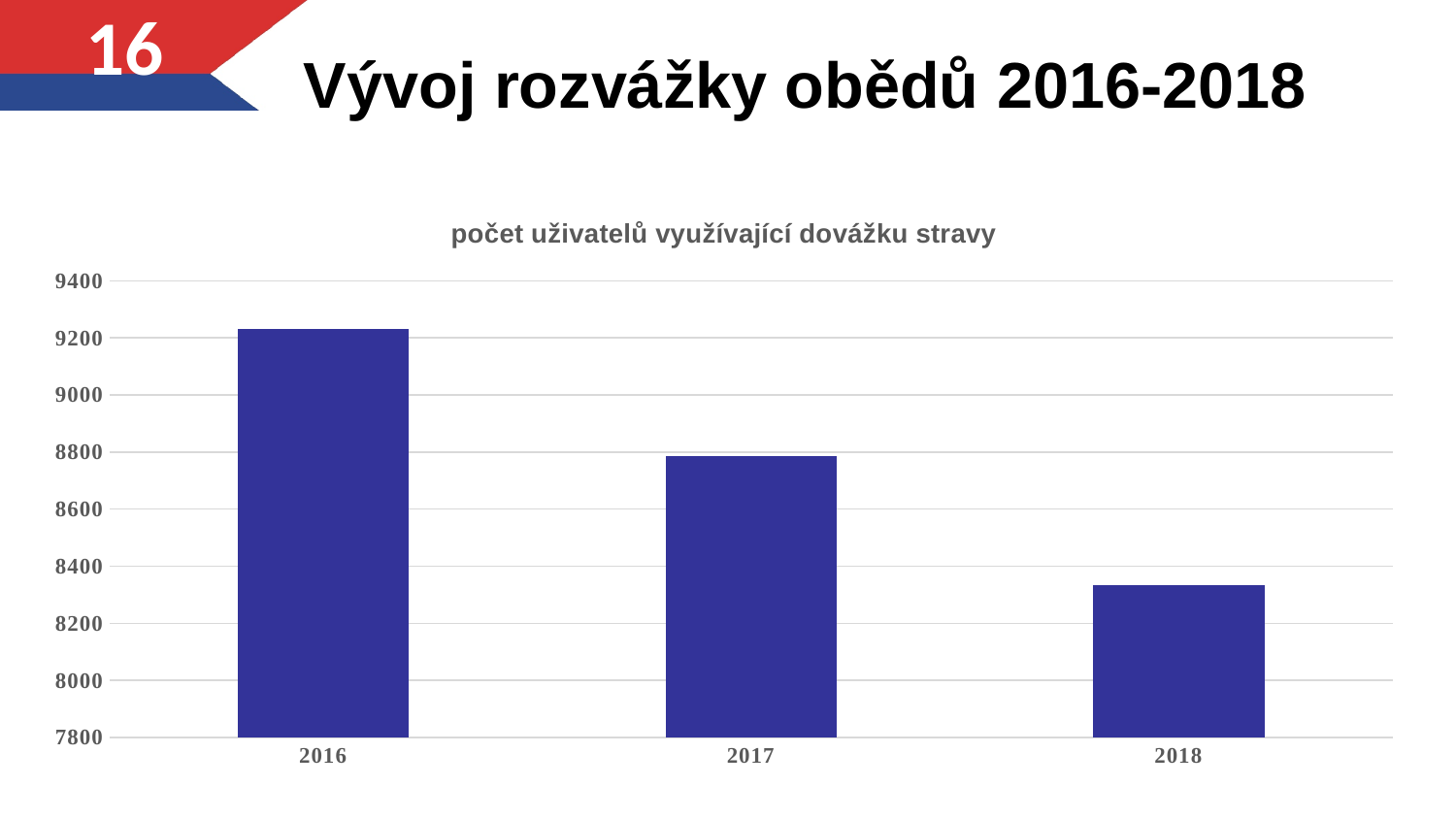
What is the lowest value shown on the vertical axis of the chart? 7800 Is the value for 2016 greater or less than 9000? greater Is the value for 2018 greater or less than 8400? less What is the title of the chart? počet uživatelů využívající dovážku stravy Is the value for 2017 greater or less than 9000? less Which year has the highest value in the chart? 2016 Do the values rise or fall from 2016 to 2018? fall What type of chart is shown on the slide? bar chart Which is larger, the value for 2017 or the value for 2018? 2017 Which year has the lowest value in the chart? 2018 How many years are shown on the x axis of the chart? 3